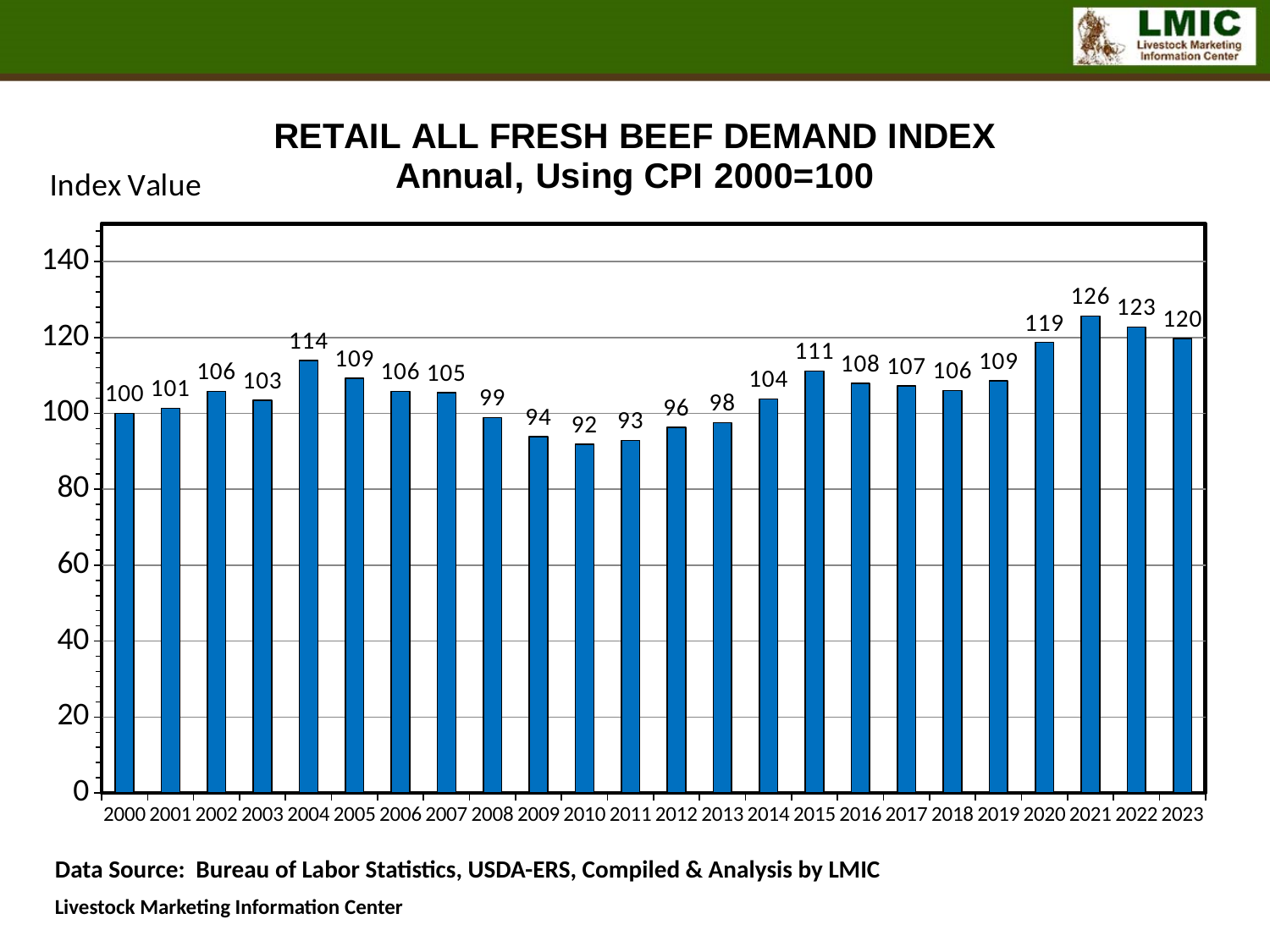
What is the index value for 2004? 114 What is the difference between the index values for 2021 and 2010? 34 Which year has the lowest index value? 2010 What is the difference between the index values for 2023 and 2000? 20 Is the index value for 2022 greater or less than 120? greater What kind of chart is shown on the slide? Bar chart What is the index value for 2010? 92 Do the index values rise or fall from 2019 to 2021? Rise Which year has a higher index value, 2015 or 2019? 2015 What is the index value for 2020? 119 How many years are shown on the x axis? 24 Which year has the highest index value? 2021